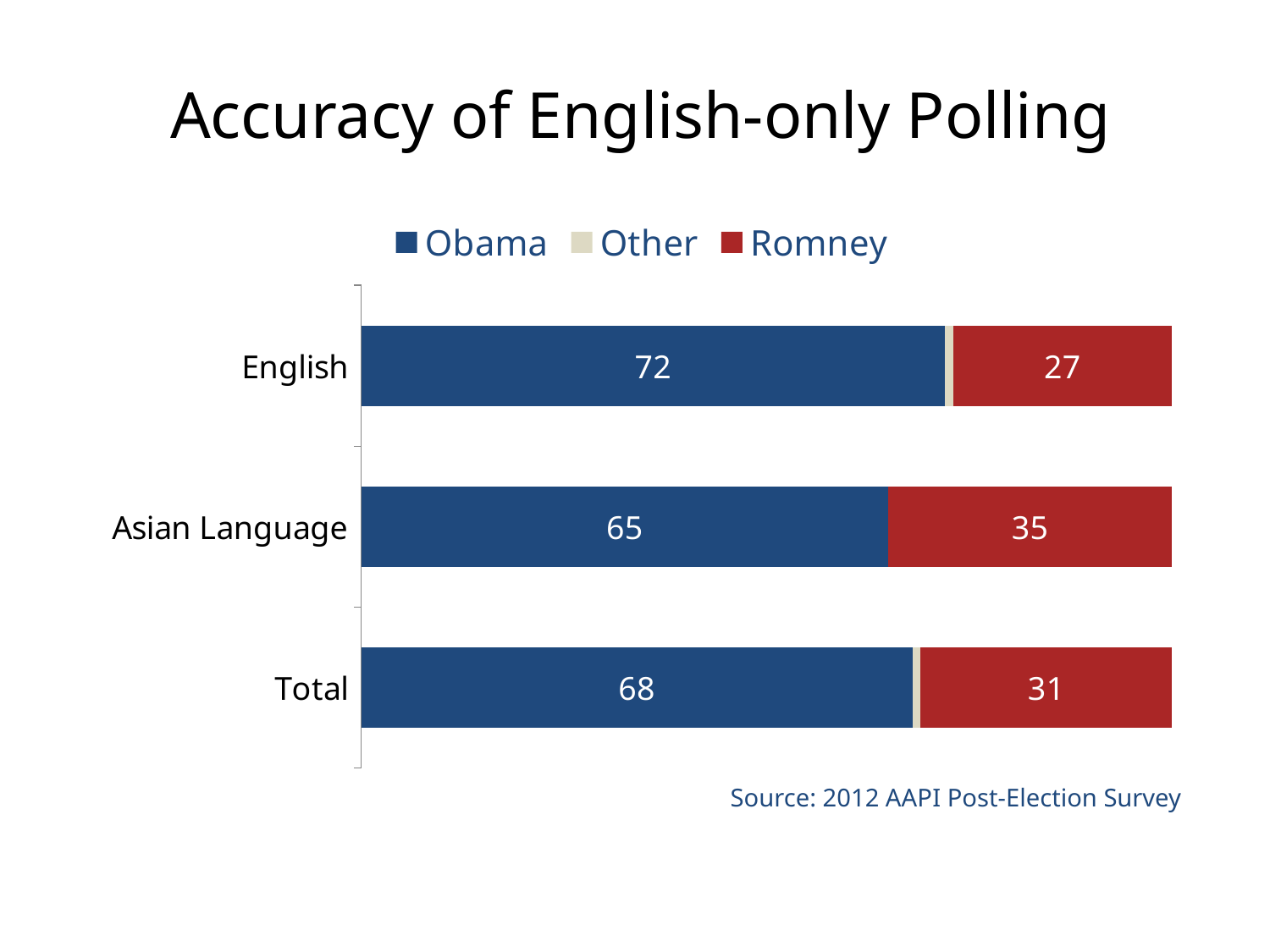
How many series does the legend list? 3 What is the Obama value for the Total category? 68 What kind of chart is shown on the slide? Stacked bar chart How many categories are shown on the chart? 3 What is the Obama value for the English category? 72 What is the difference between the Romney values for Asian Language and Total? 4 Which is larger: the Obama value for Asian Language or the Obama value for Total? Total What is the difference between the Obama values for English and Asian Language? 7 What is the Romney value for the Asian Language category? 35 What is the Romney value for the English category? 27 Which category has the lowest Romney value? English Which category has the highest Obama value? English